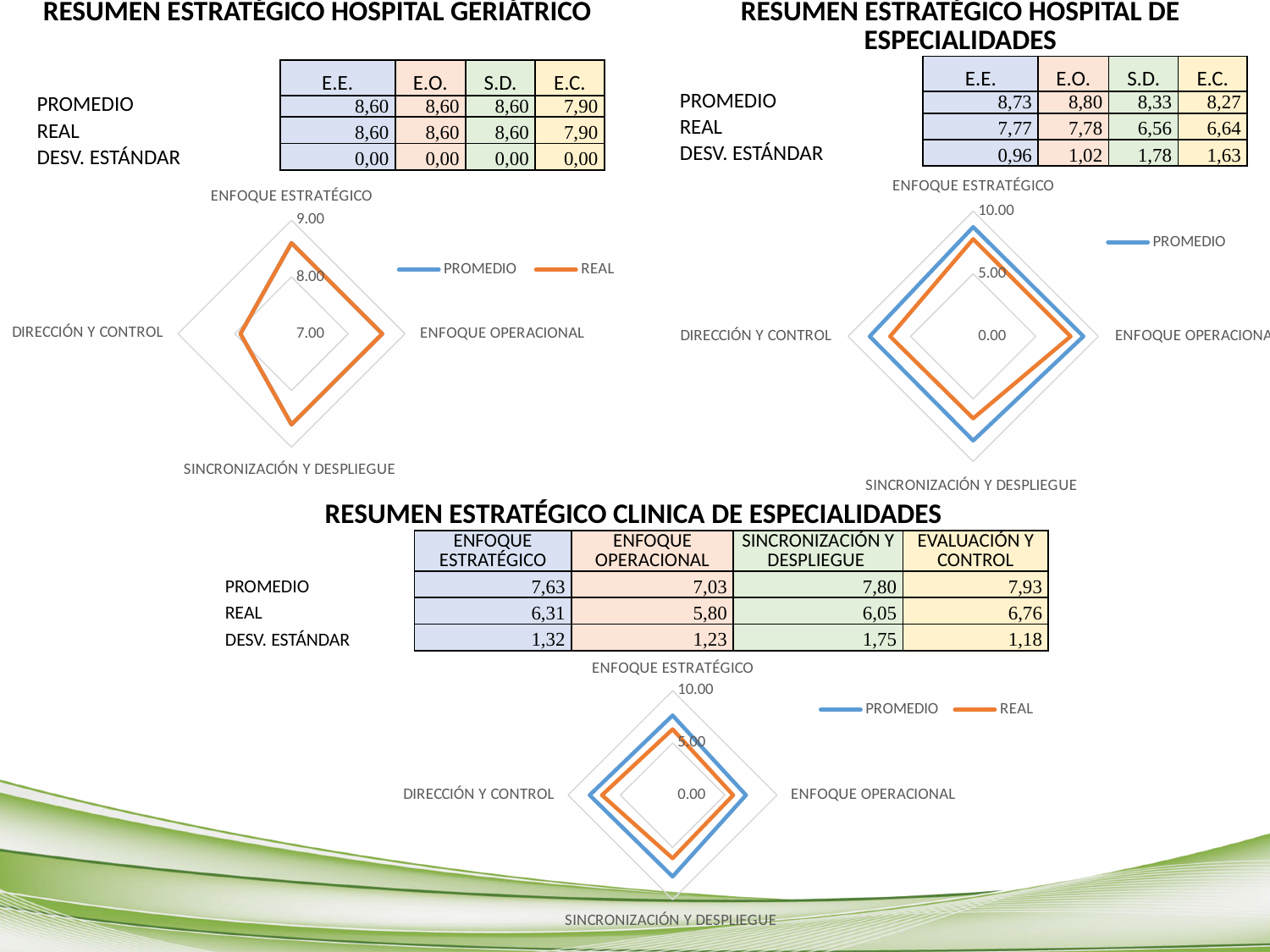
In the RESUMEN ESTRATÉGICO HOSPITAL GERIÁTRICO table, what is the REAL value for E.C.? 7,90 In the RESUMEN ESTRATÉGICO HOSPITAL DE ESPECIALIDADES table, which category has the lowest REAL value? S.D. In the RESUMEN ESTRATÉGICO HOSPITAL DE ESPECIALIDADES table, which has the larger REAL value, E.E. or E.C.? E.E. In the RESUMEN ESTRATÉGICO CLINICA DE ESPECIALIDADES table, what is the difference between the PROMEDIO and REAL values for ENFOQUE ESTRATÉGICO? 1,32 In the RESUMEN ESTRATÉGICO CLINICA DE ESPECIALIDADES table, what is the REAL value for ENFOQUE OPERACIONAL? 5,80 In the RESUMEN ESTRATÉGICO HOSPITAL GERIÁTRICO chart, how many series does the legend list? 2 What kind of chart is shown under the RESUMEN ESTRATÉGICO HOSPITAL GERIÁTRICO title? Radar chart In the RESUMEN ESTRATÉGICO CLINICA DE ESPECIALIDADES chart, how many axis categories are plotted? 4 In the RESUMEN ESTRATÉGICO HOSPITAL DE ESPECIALIDADES chart, how many series does the legend list? 1 In the RESUMEN ESTRATÉGICO CLINICA DE ESPECIALIDADES chart, is the REAL value for SINCRONIZACIÓN Y DESPLIEGUE greater or less than 5.00? greater In the RESUMEN ESTRATÉGICO CLINICA DE ESPECIALIDADES table, which category has the highest PROMEDIO value? EVALUACIÓN Y CONTROL In the RESUMEN ESTRATÉGICO HOSPITAL DE ESPECIALIDADES table, what is the PROMEDIO value for E.E.? 8,73